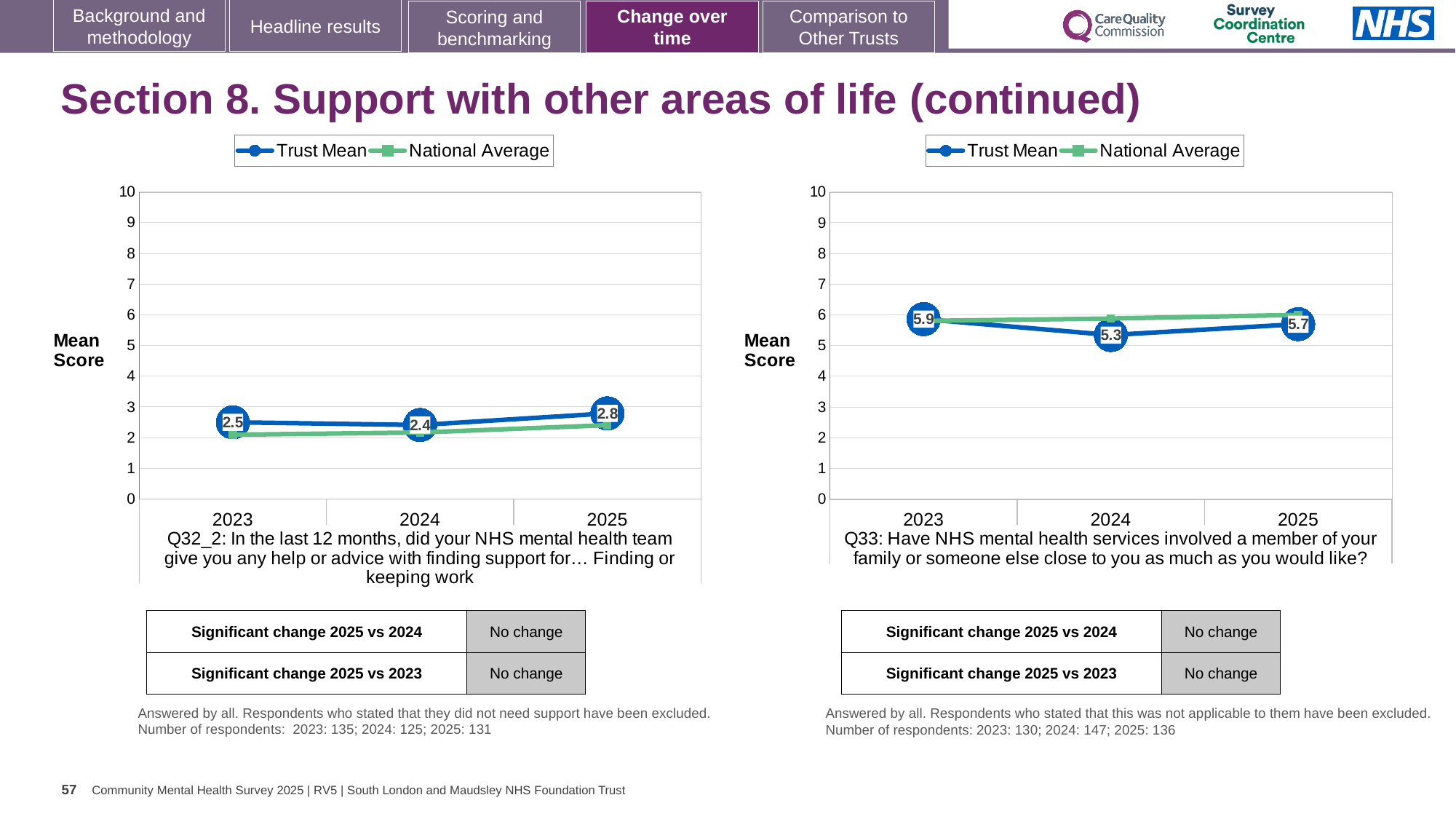
On the right chart (Q33), what is the Trust Mean for 2024? 5.3 On the left chart (Q32_2), what is the difference between the Trust Mean in 2025 and 2024? 0.4 On the left chart (Q32_2), in which year is the Trust Mean highest? 2025 On the left chart (Q32_2), what is the Trust Mean for 2025? 2.8 How many series does the legend of the right chart (Q33) list? 2 What kind of chart is the left chart (Q32_2)? Line chart On the left chart (Q32_2), is the National Average for 2023 greater or less than 3? less On the right chart (Q33), what is the difference between the Trust Mean in 2023 and 2024? 0.6 On the left chart (Q32_2), what is the Trust Mean for 2024? 2.4 On the right chart (Q33), what is the Trust Mean for 2023? 5.9 On the right chart (Q33), is the Trust Mean for 2025 greater or less than the Trust Mean for 2024? greater On the right chart (Q33), in which year is the Trust Mean lowest? 2024